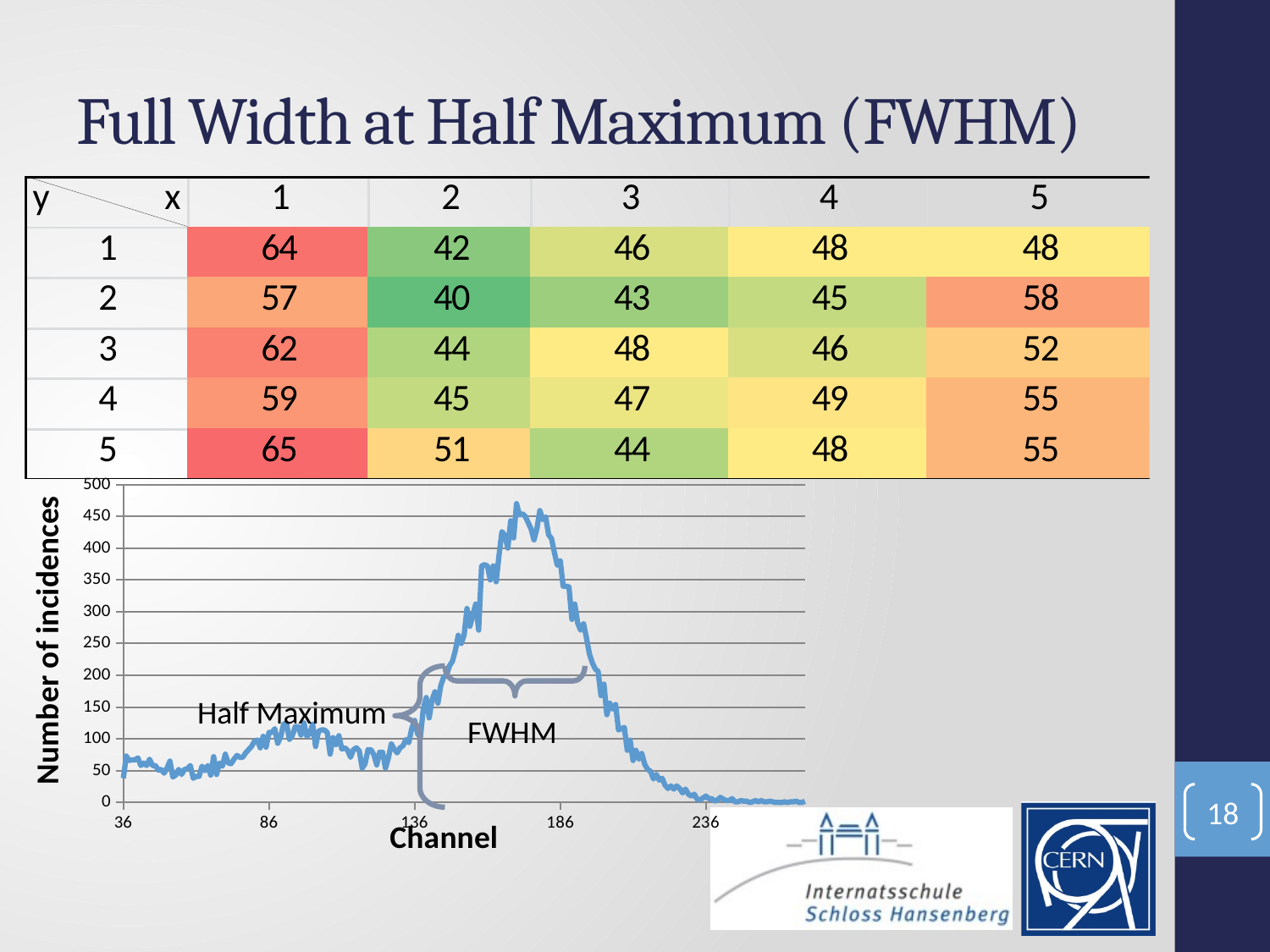
Is the channel at which the main peak occurs greater or less than 136? greater Is the channel at which the main peak occurs greater or less than 186? less Which is larger, the value of the curve at channel 86 or at channel 236? channel 86 Is the value of the curve at channel 236 greater or less than 50? less What kind of chart is shown on the slide? line chart What is the title of the x axis of the chart? Channel What is the title of the y axis of the chart? Number of incidences What is the highest value shown on the y axis of the chart? 500